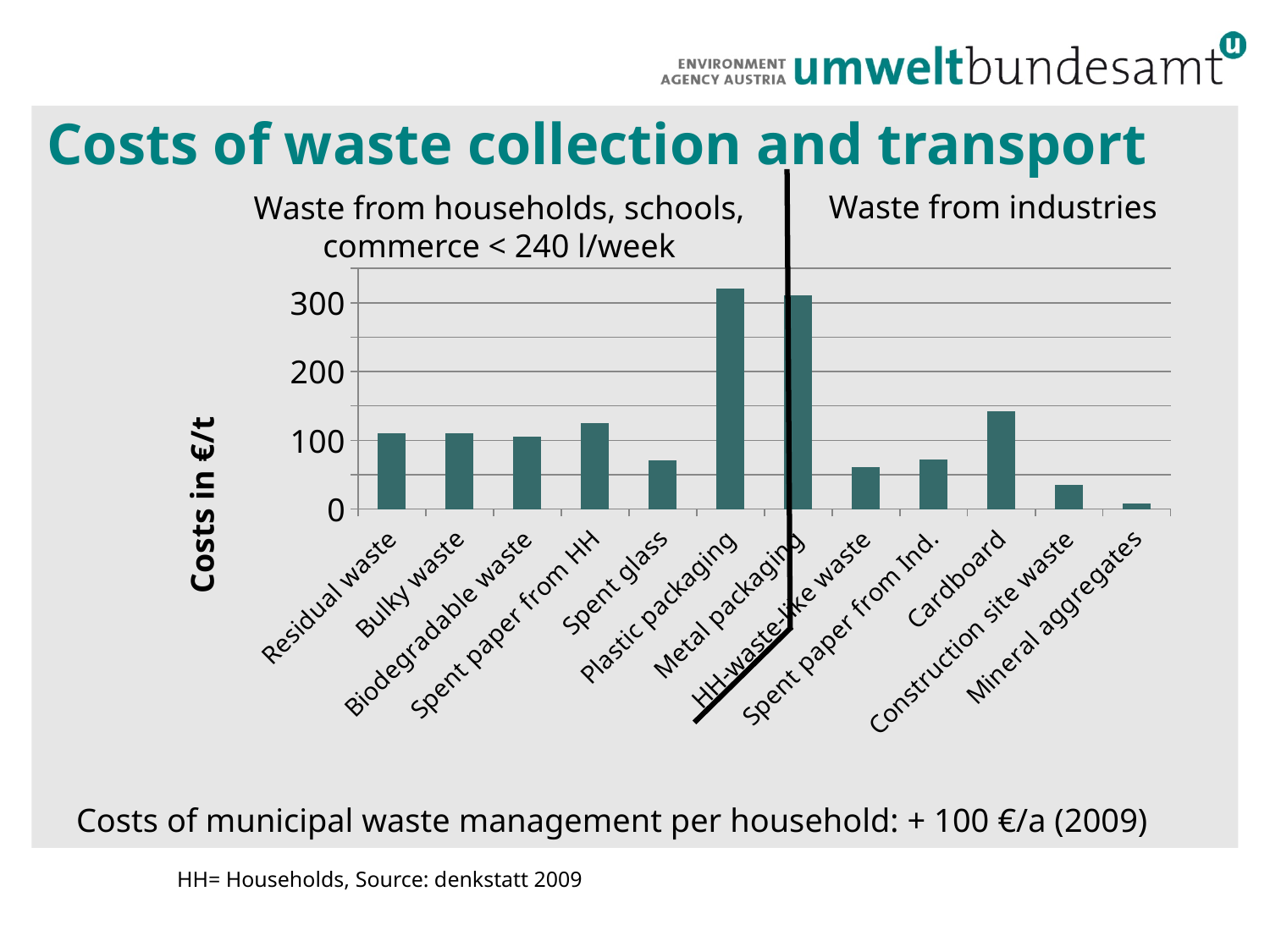
Which waste category has the lowest cost in the chart? Mineral aggregates What is the title of the chart on the slide? Costs of waste collection and transport What is the label of the vertical axis of the chart? Costs in €/t Is the value for Plastic packaging greater or less than 300? greater Which has the higher cost, Cardboard or Spent glass? Cardboard Is the value for Spent glass greater or less than 100? less Is the value for Metal packaging greater or less than 200? greater Which has the higher cost, Construction site waste or Mineral aggregates? Construction site waste How many waste categories are plotted on the x axis? 12 What kind of chart is shown on the slide? Bar chart